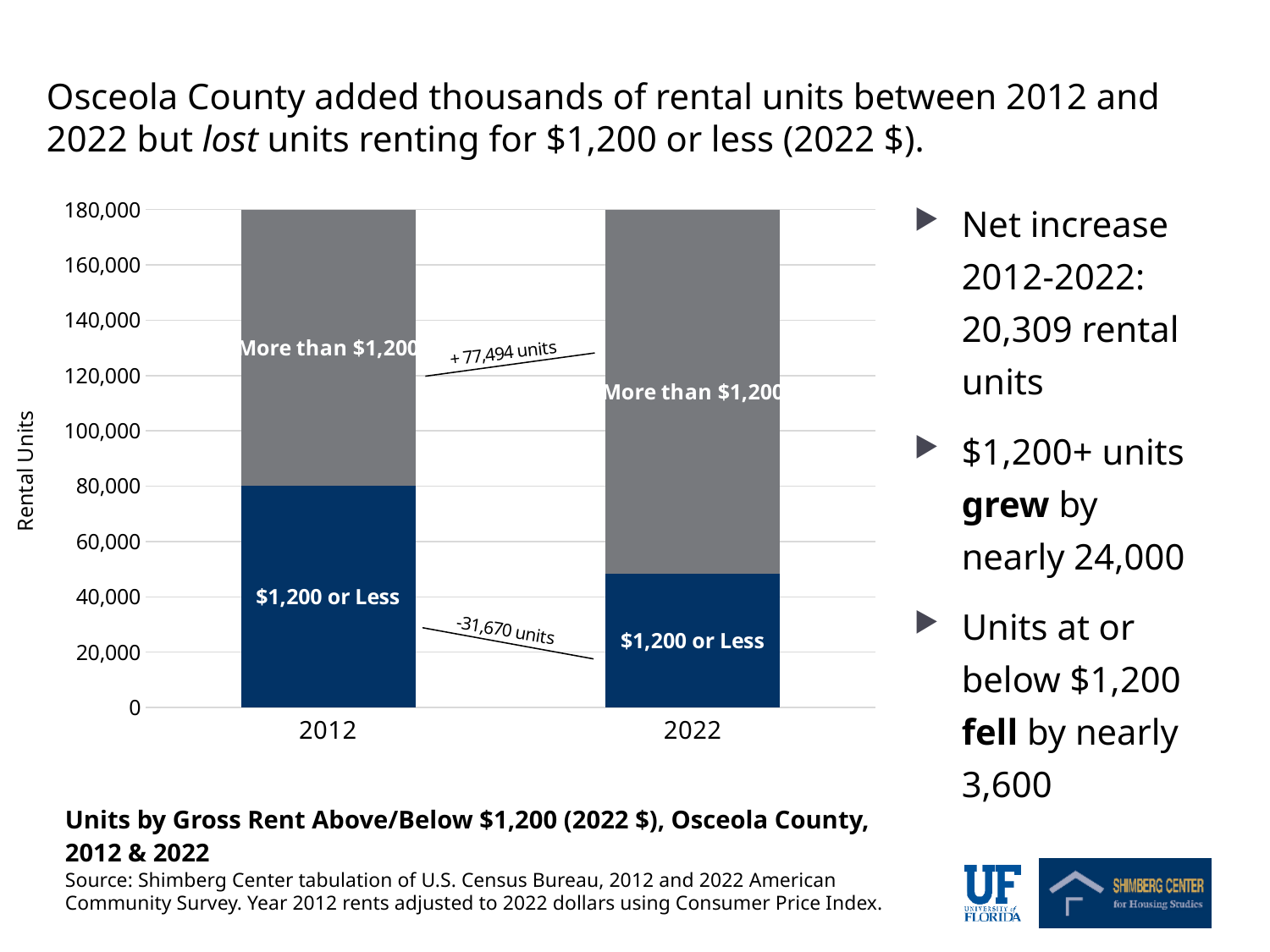
Is the number of '$1,200 or Less' units in 2012 greater or less than 60,000? greater What is the title of the chart? Units by Gross Rent Above/Below $1,200 (2022 $), Osceola County, 2012 & 2022 How many years (categories) are shown on the x axis of the chart? 2 How many rent segments make up each stacked bar in the chart? 2 Is the number of '$1,200 or Less' units in 2022 greater or less than 40,000? greater What change in units is annotated between the '$1,200 or Less' segments of the 2012 and 2022 bars? -31,670 units Is the number of '$1,200 or Less' units in 2012 greater or less than 100,000? less Which year has the larger '$1,200 or Less' segment, 2012 or 2022? 2012 What kind of chart is shown on the slide? Stacked bar chart What is the title of the y axis in the chart? Rental Units Which year has the larger 'More than $1,200' segment, 2012 or 2022? 2022